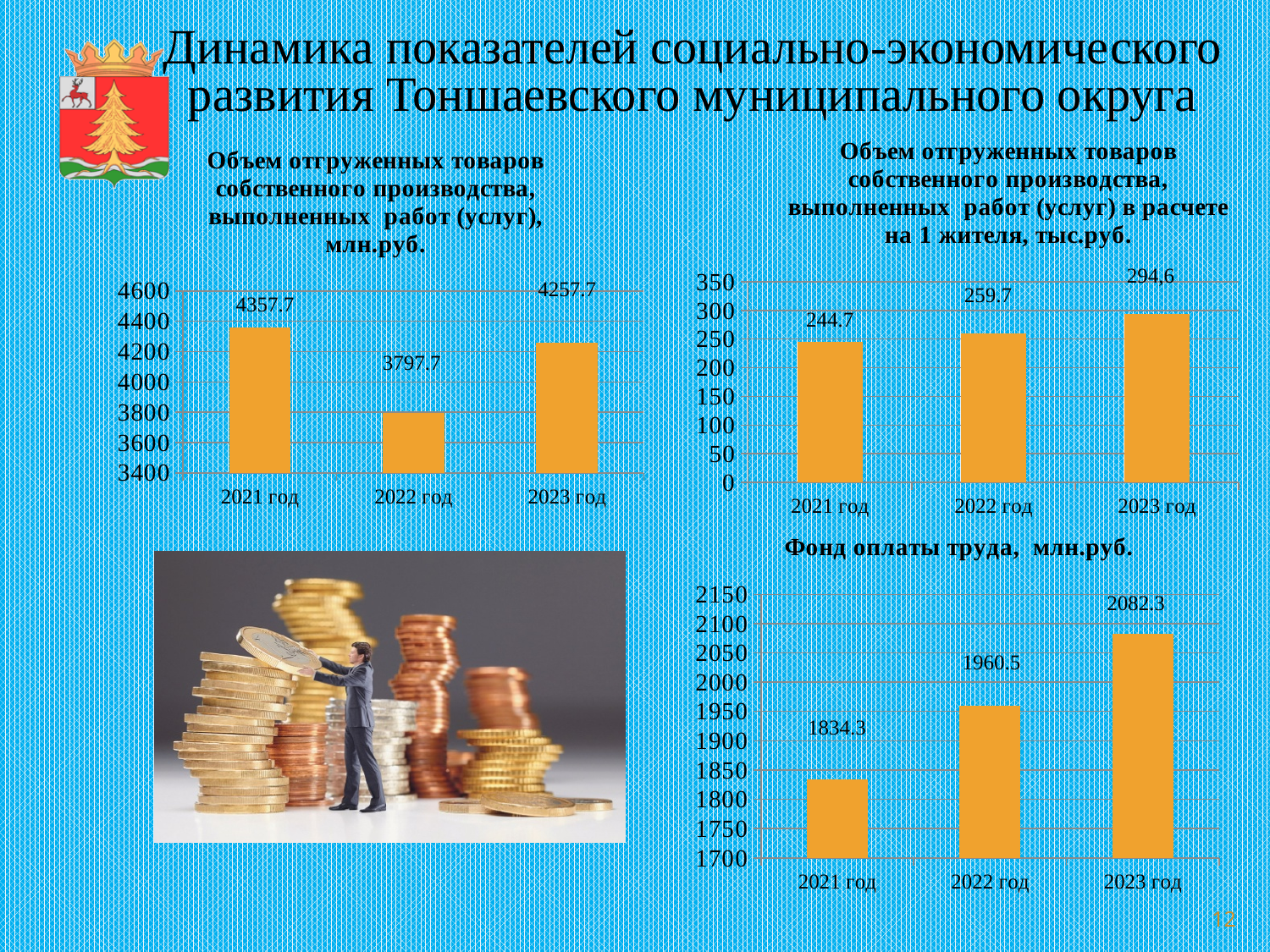
In the top-right chart (тыс.руб. на 1 жителя), how many bars are plotted? 3 In the top-left chart (млн.руб.), which year has the highest value? 2021 год In the chart 'Фонд оплаты труда, млн.руб.', is the value for 2022 год greater or less than 2000? less In the top-right chart (тыс.руб. на 1 жителя), do the values rise or fall from 2021 год to 2023 год? rise In the chart 'в расчете на 1 жителя, тыс.руб.' (top right), what is the value for 2023 год? 294,6 In the top-left chart (млн.руб.), what is the difference between the values for 2021 год and 2022 год? 560.0 In the top-left chart (млн.руб.), which is larger: the value for 2021 год or 2023 год? 2021 год In the chart 'Фонд оплаты труда, млн.руб.', what is the difference between the values for 2023 год and 2022 год? 121.8 What type of chart is 'Фонд оплаты труда, млн.руб.'? bar chart In the top-right chart (тыс.руб. на 1 жителя), which year has the lowest value? 2021 год In the chart 'Фонд оплаты труда, млн.руб.', what is the value for 2021 год? 1834.3 In the chart 'Объем отгруженных товаров собственного производства, выполненных работ (услуг), млн.руб.' (top left), what is the value for 2022 год? 3797.7